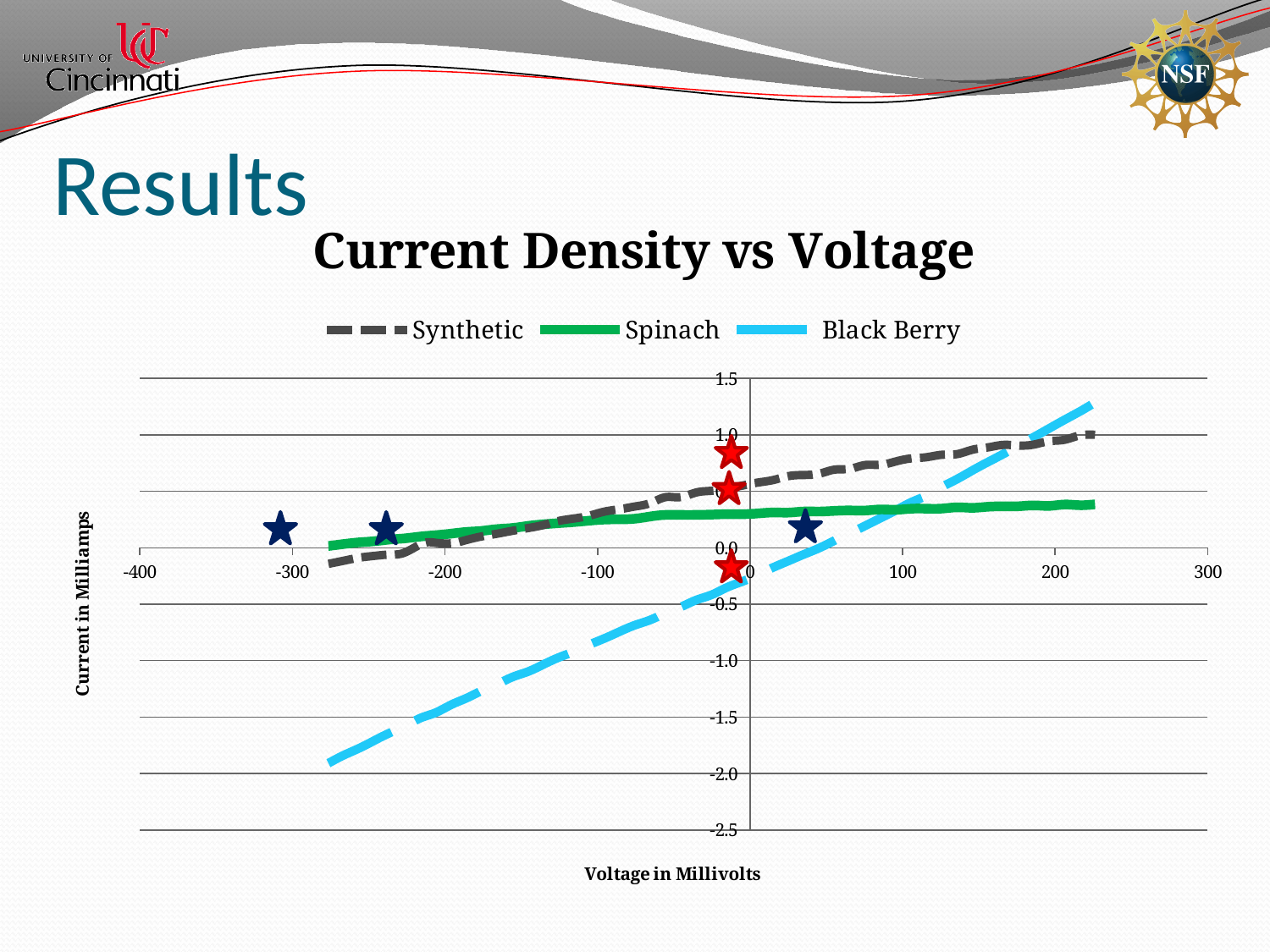
Does the Synthetic series rise or fall as voltage increases along the x axis? rise At -200 millivolts, which series has the higher current: Spinach or Black Berry? Spinach How many series does the legend of the Current Density vs Voltage chart list? 3 Does the Black Berry series rise or fall as voltage increases from -300 to 200 millivolts? rise Is the value of the Spinach series at 200 millivolts greater or less than 0.5? less Is the value of the Black Berry series at 0 millivolts greater or less than 0.0? less What kind of chart is shown on the slide? line chart Is the value of the Black Berry series at 200 millivolts greater or less than 1.0? greater At 200 millivolts, which series has the higher current: Black Berry or Spinach? Black Berry What is the title of the chart? Current Density vs Voltage What is the label of the y axis of the chart? Current in Milliamps